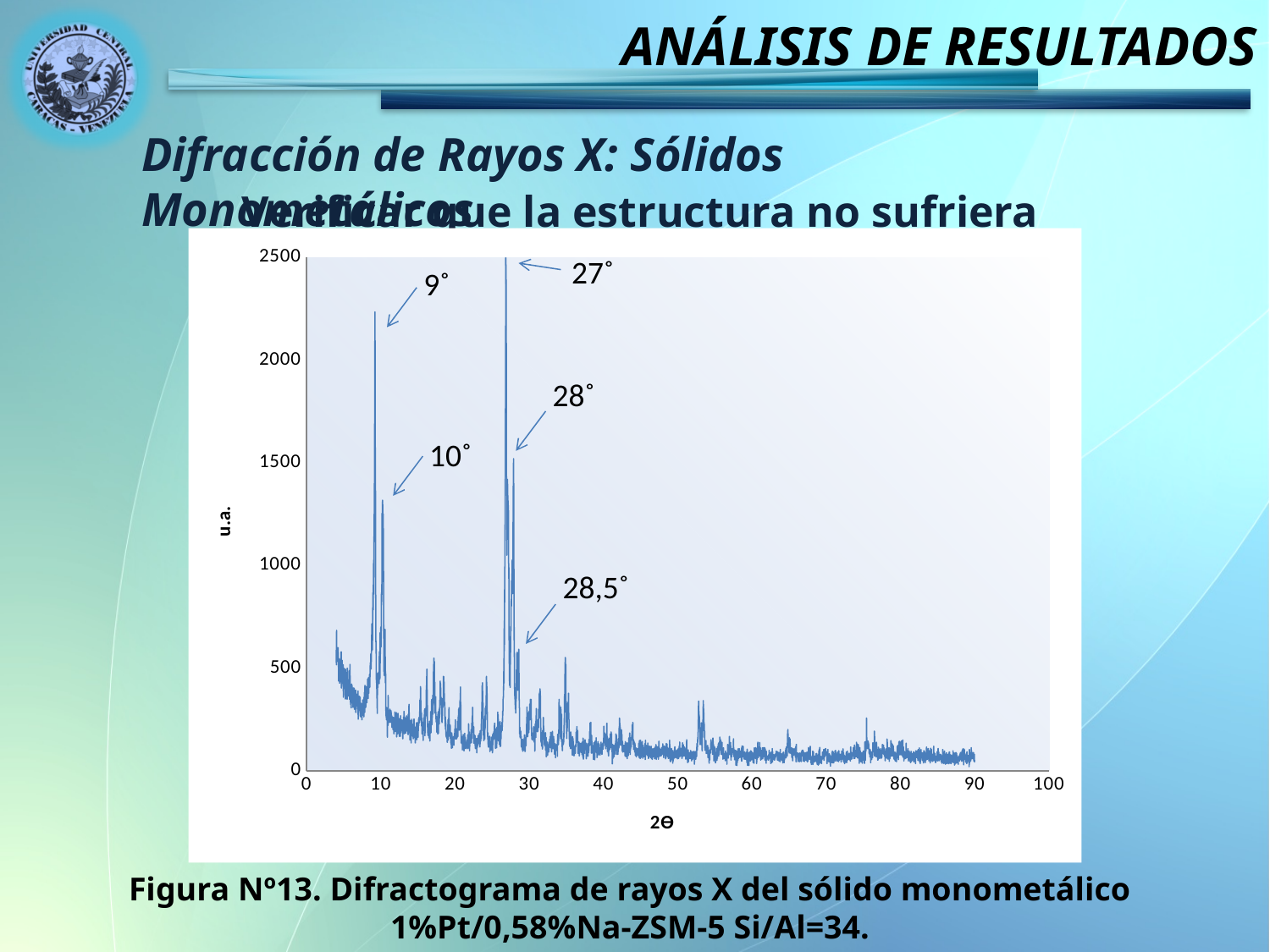
Is the intensity of the peak at 9˚ greater or less than 2000? greater Which of the two peaks is higher, the one at 9˚ or the one at 10˚? 9˚ What is the label of the y axis of the chart? u.a. Beyond 2Θ = 30, does the intensity generally rise or fall as 2Θ increases? fall Which annotated peak has the lowest intensity? 28,5˚ Which of the two peaks is higher, the one at 28˚ or the one at 28,5˚? 28˚ Which annotated peak has the highest intensity? 27˚ What kind of chart is shown on the slide? line chart Is the intensity of the peak at 10˚ greater or less than 1000? greater What is the label of the x axis of the chart? 2Θ How many peaks are annotated with angle labels on the chart? 5 Is the intensity of the peak at 28,5˚ greater or less than 1000? less